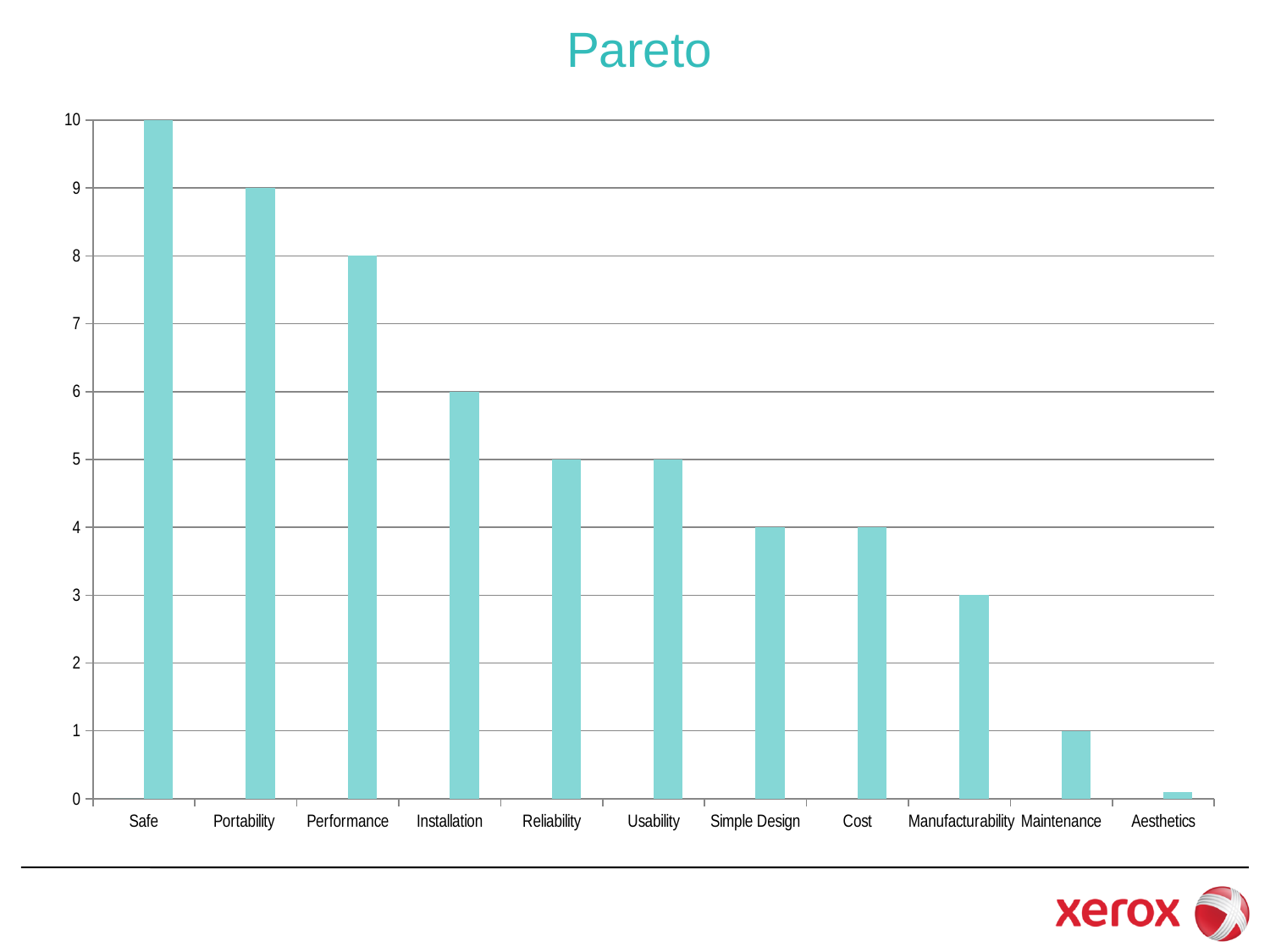
What is the title of the chart? Pareto What is the value for Manufacturability? 3 What type of chart is shown on the slide? bar chart Which category has the lowest value? Aesthetics Which is larger, the value for Reliability or the value for Maintenance? Reliability Which category has the highest value? Safe What is the value for Installation? 6 Is the value for Aesthetics greater or less than 1? less How many categories are plotted on the x axis? 11 What is the difference between the values for Performance and Cost? 4 What is the value for Portability? 9 What is the value for Safe? 10